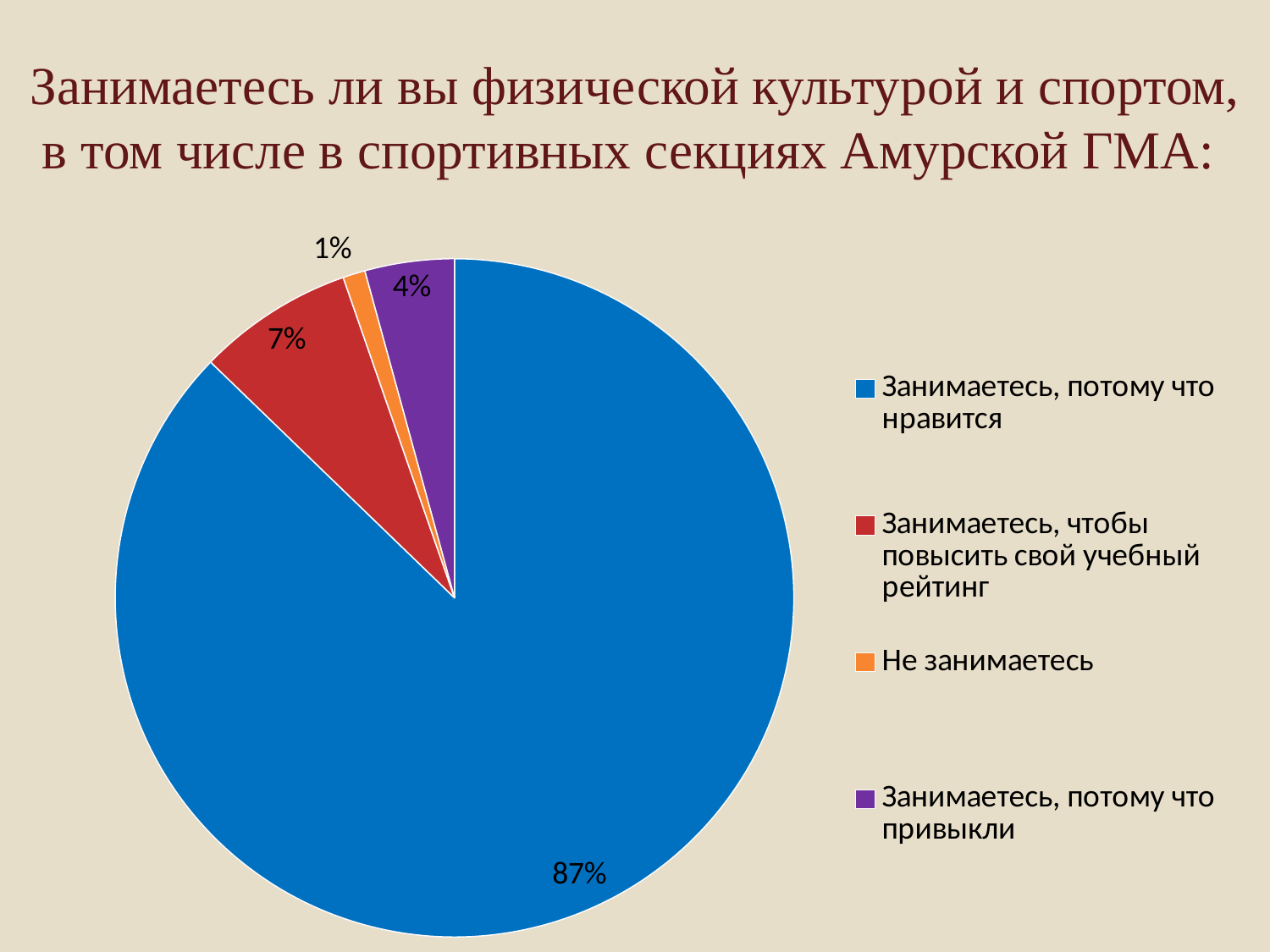
What share of respondents answered "Занимаетесь, чтобы повысить свой учебный рейтинг"? 7% What is the difference between the shares for "Занимаетесь, потому что привыкли" and "Не занимаетесь"? 3% What colour is the slice for "Не занимаетесь"? orange What share of respondents answered "Занимаетесь, потому что нравится"? 87% Which category has the largest slice of the pie? Занимаетесь, потому что нравится What share of respondents answered "Не занимаетесь"? 1% How many categories does the legend list? 4 Which is larger: the share for "Занимаетесь, чтобы повысить свой учебный рейтинг" or the share for "Занимаетесь, потому что привыкли"? Занимаетесь, чтобы повысить свой учебный рейтинг What share of respondents answered "Занимаетесь, потому что привыкли"? 4% Which category has the smallest slice of the pie? Не занимаетесь What kind of chart is shown on the slide? pie chart What is the difference between the shares for "Занимаетесь, потому что нравится" and "Занимаетесь, чтобы повысить свой учебный рейтинг"? 80%